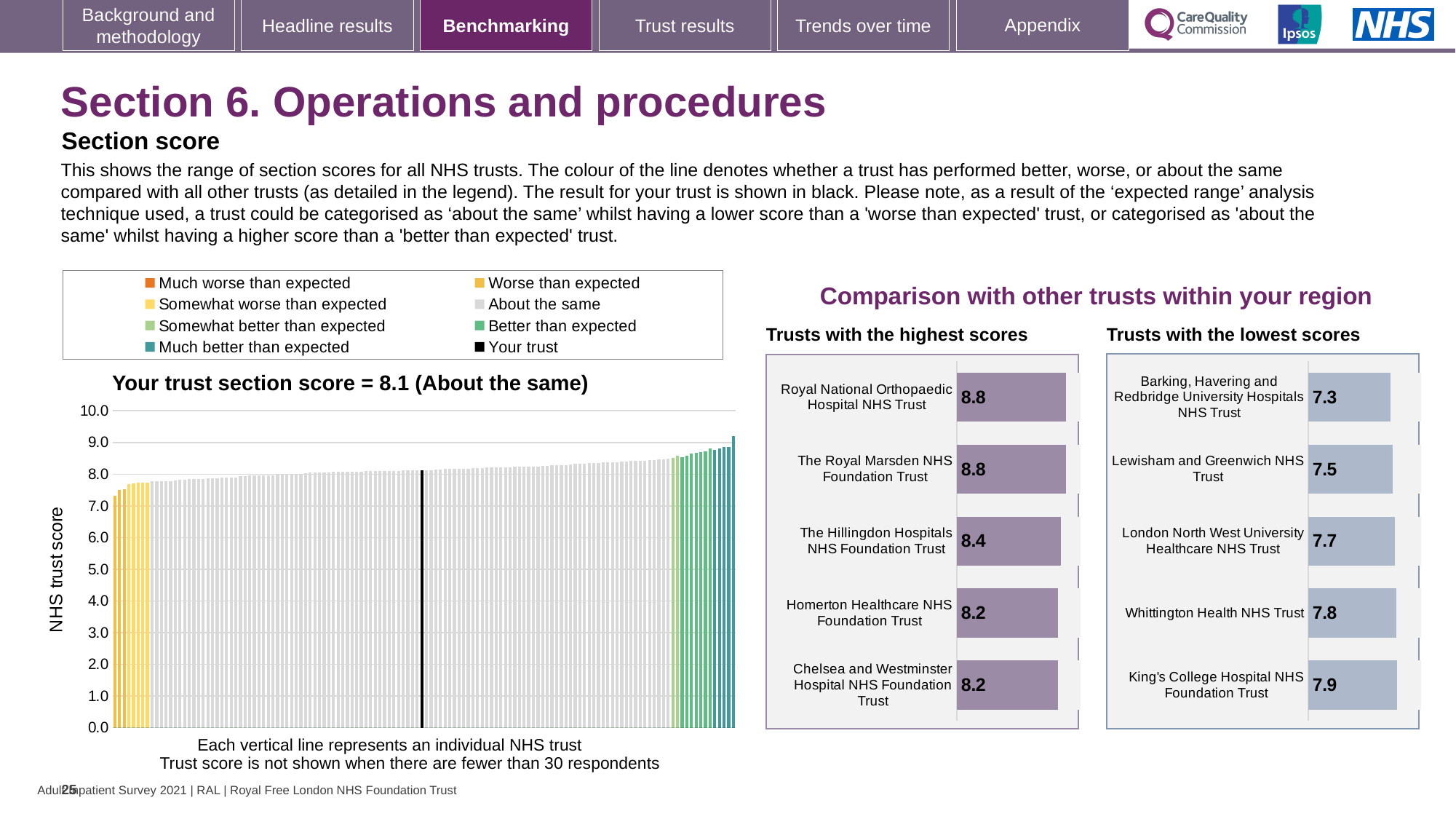
In the 'Your trust section score' chart, what is the section score for your trust? 8.1 How many entries does the legend above the 'Your trust section score' chart list? 8 In the 'Your trust section score' chart, what kind of chart is shown? bar chart In the 'Trusts with the lowest scores' chart, what is the difference between the scores of King's College Hospital NHS Foundation Trust and Barking, Havering and Redbridge University Hospitals NHS Trust? 0.6 In the 'Your trust section score' chart, what is the label on the y axis? NHS trust score In the 'Trusts with the highest scores' chart, what is the difference between the scores of Royal National Orthopaedic Hospital NHS Trust and The Hillingdon Hospitals NHS Foundation Trust? 0.4 In the 'Trusts with the highest scores' chart, which has the larger score: The Hillingdon Hospitals NHS Foundation Trust or Homerton Healthcare NHS Foundation Trust? The Hillingdon Hospitals NHS Foundation Trust In the 'Trusts with the highest scores' chart, what is the score for The Hillingdon Hospitals NHS Foundation Trust? 8.4 In the 'Your trust section score' chart, do the trust scores rise or fall from left to right along the x axis? rise In the 'Trusts with the highest scores' chart, how many trusts are shown? 5 In the 'Trusts with the lowest scores' chart, what is the score for Whittington Health NHS Trust? 7.8 In the 'Trusts with the lowest scores' chart, which trust has the lowest score? Barking, Havering and Redbridge University Hospitals NHS Trust